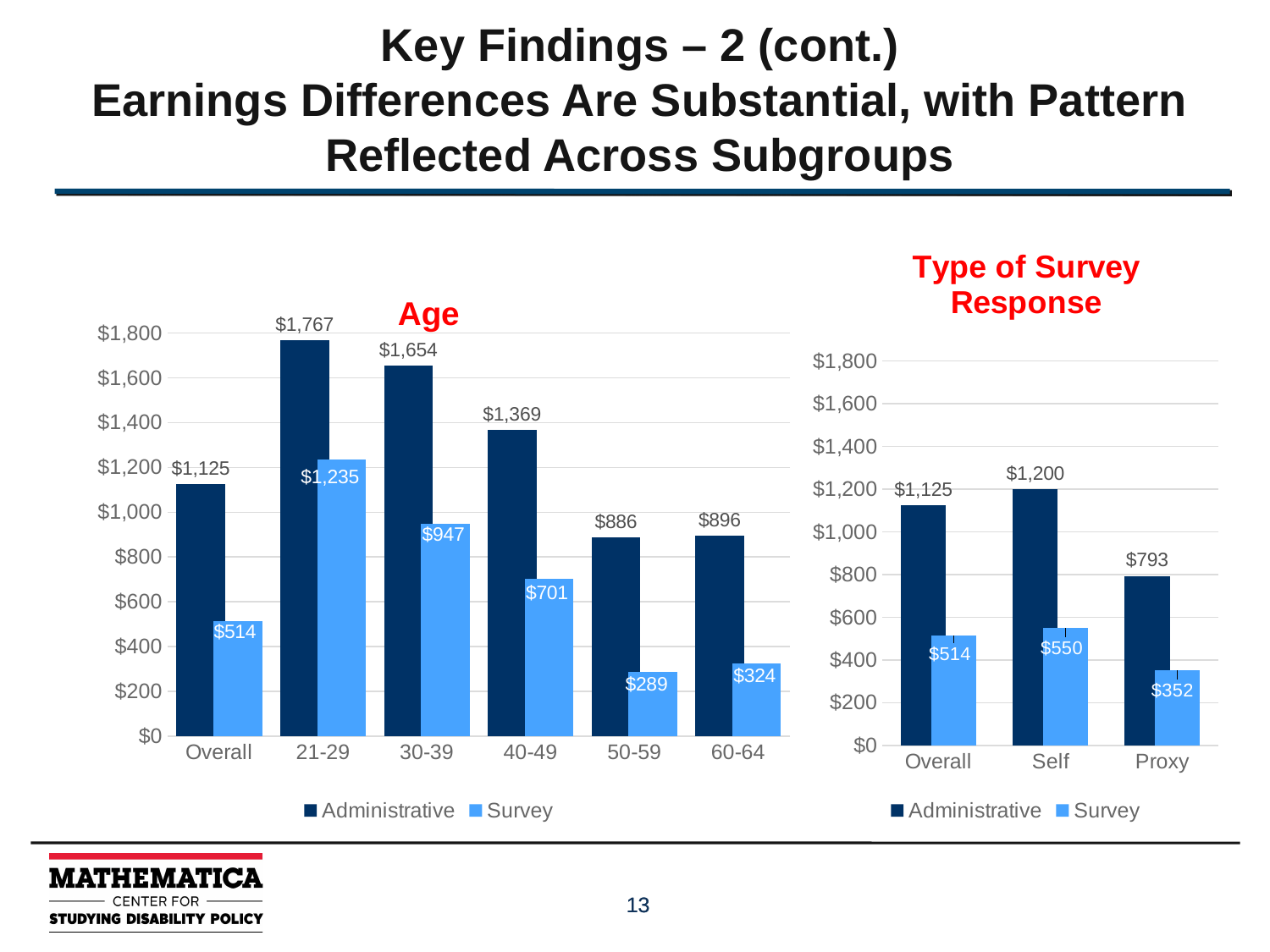
In the Type of Survey Response chart, what is the difference between the Administrative and Survey values for Self? $650 What type of chart is the Age chart? Bar chart In the Age chart, what is the difference between the Administrative values for 30-39 and 40-49? $285 In the Age chart, which age group has the highest Administrative value? 21-29 In the Type of Survey Response chart, which category has the lowest Administrative value? Proxy In the Age chart, which is larger: the Survey value for 60-64 or the Survey value for 50-59? 60-64 In the Age chart, what is the Survey value for the 40-49 group? $701 How many categories are shown on the x axis of the Age chart? 6 In the Age chart, what is the Administrative value for the 21-29 group? $1,767 How many series does the legend of the Type of Survey Response chart list? 2 In the Age chart, which category has the lowest Survey value? 50-59 In the Type of Survey Response chart, what is the Survey value for Proxy? $352